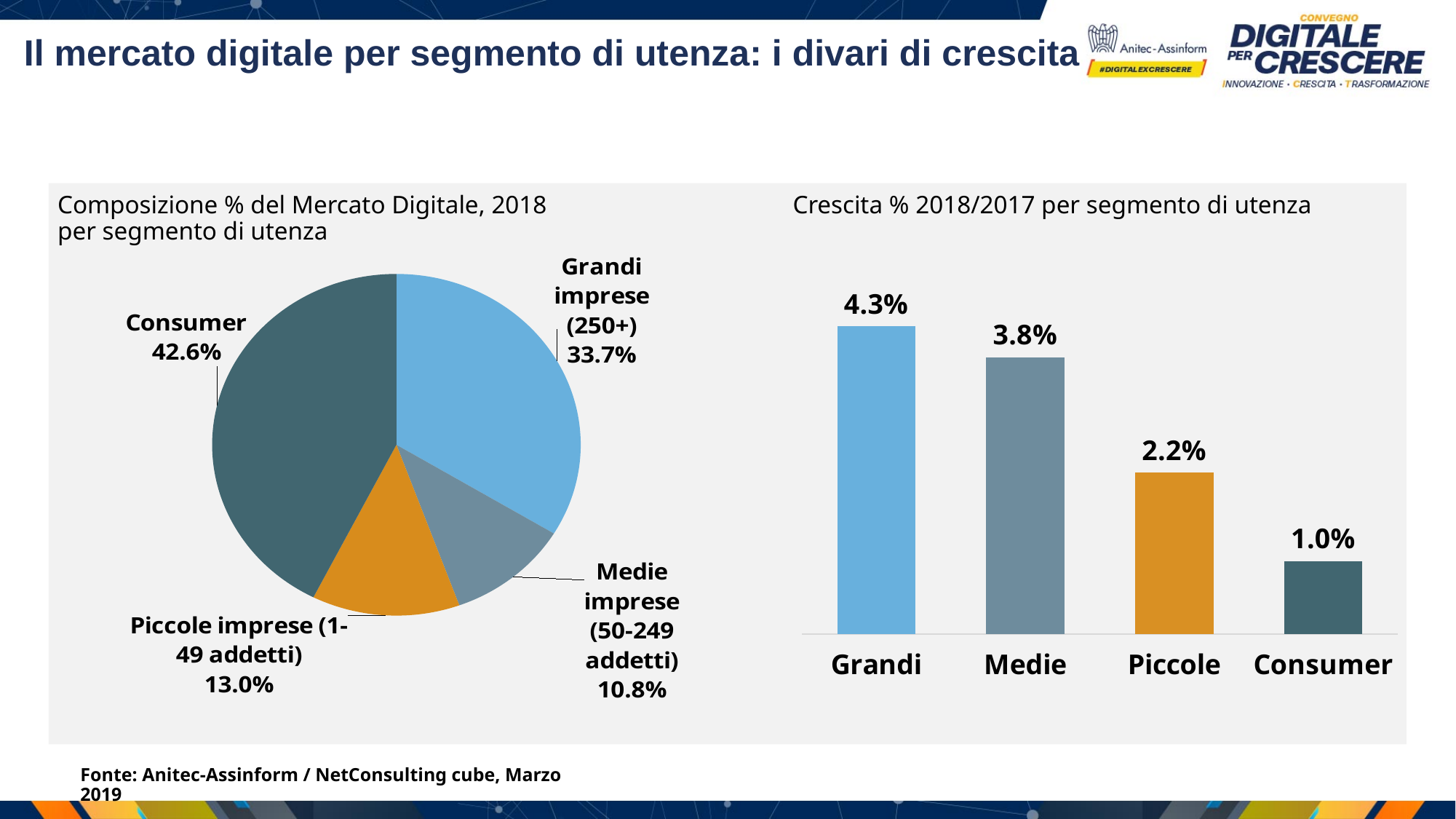
In the bar chart on the right, do the values rise or fall from left to right? fall In the bar chart on the right, which segment has the lowest growth? Consumer In the bar chart on the right, what is the difference between the growth of Grandi and Piccole? 2.1% In the pie chart on the left, which segment has the largest share? Consumer In the pie chart on the left, how many slices are there? 4 In the pie chart on the left, what is the difference between the Consumer share and the Piccole imprese share? 29.6% In the pie chart on the left, what is the share for Grandi imprese (250+)? 33.7% What type of chart is shown on the right side of the slide? bar chart In the bar chart on the right, which segment has the highest growth? Grandi In the pie chart on the left, which segment has the smallest share? Medie imprese (50-249 addetti) In the bar chart on the right, what is the growth value for Medie? 3.8% In the pie chart on the left, what share of the digital market does Consumer hold? 42.6%